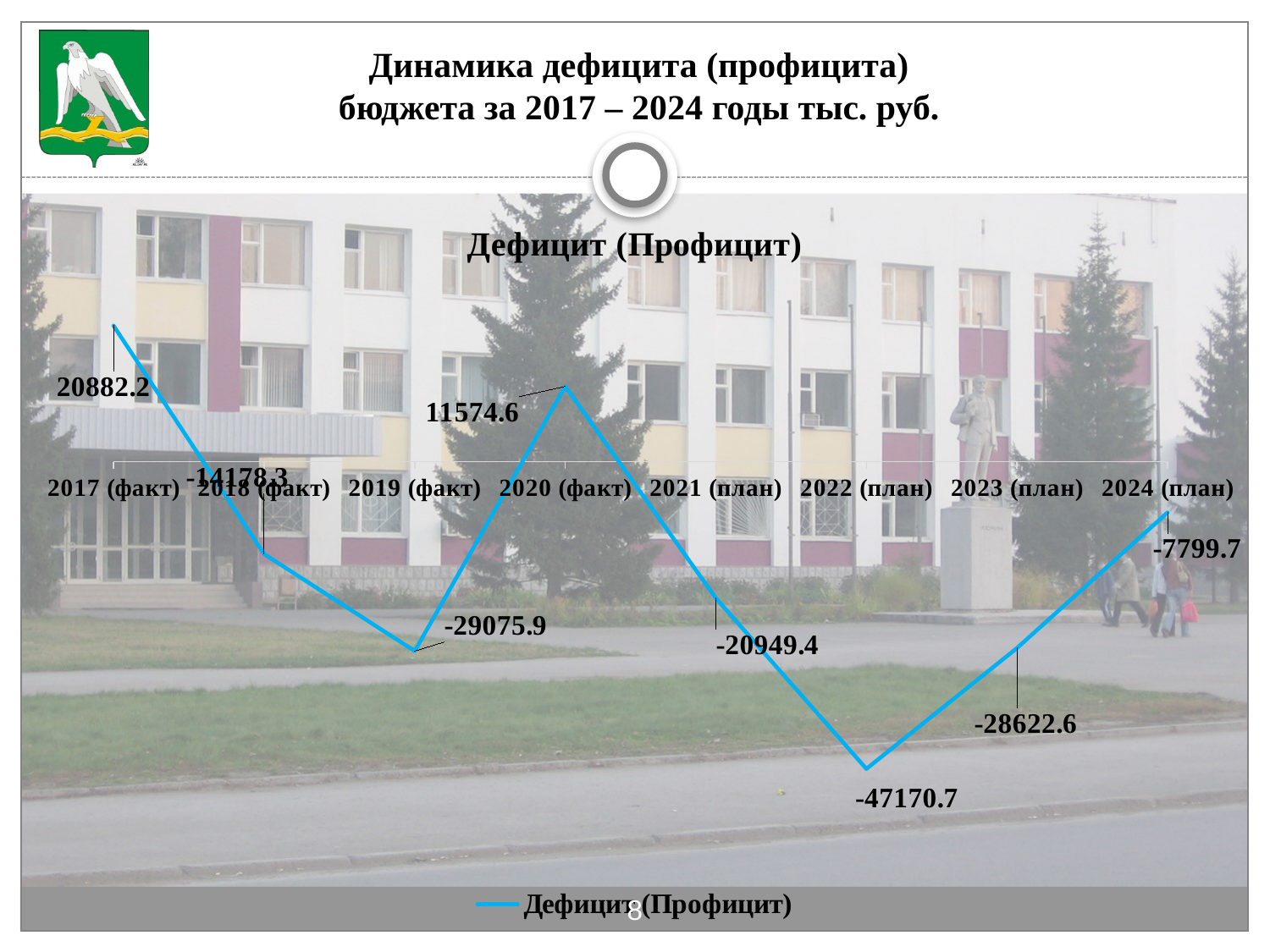
Which year has the lowest value? 2022 (план) What is the value for 2022 (план)? -47170.7 What is the value for 2019 (факт)? -29075.9 What is the value for 2024 (план)? -7799.7 How many years are plotted on the chart? 8 What type of chart is shown on the slide? line chart What is the value for 2017 (факт)? 20882.2 Which is larger, the value for 2021 (план) or the value for 2023 (план)? 2021 (план) What is the title of the chart? Дефицит (Профицит) What is the value for 2020 (факт)? 11574.6 What is the difference between the values for 2017 (факт) and 2020 (факт)? 9307.6 Which year has the highest value? 2017 (факт)